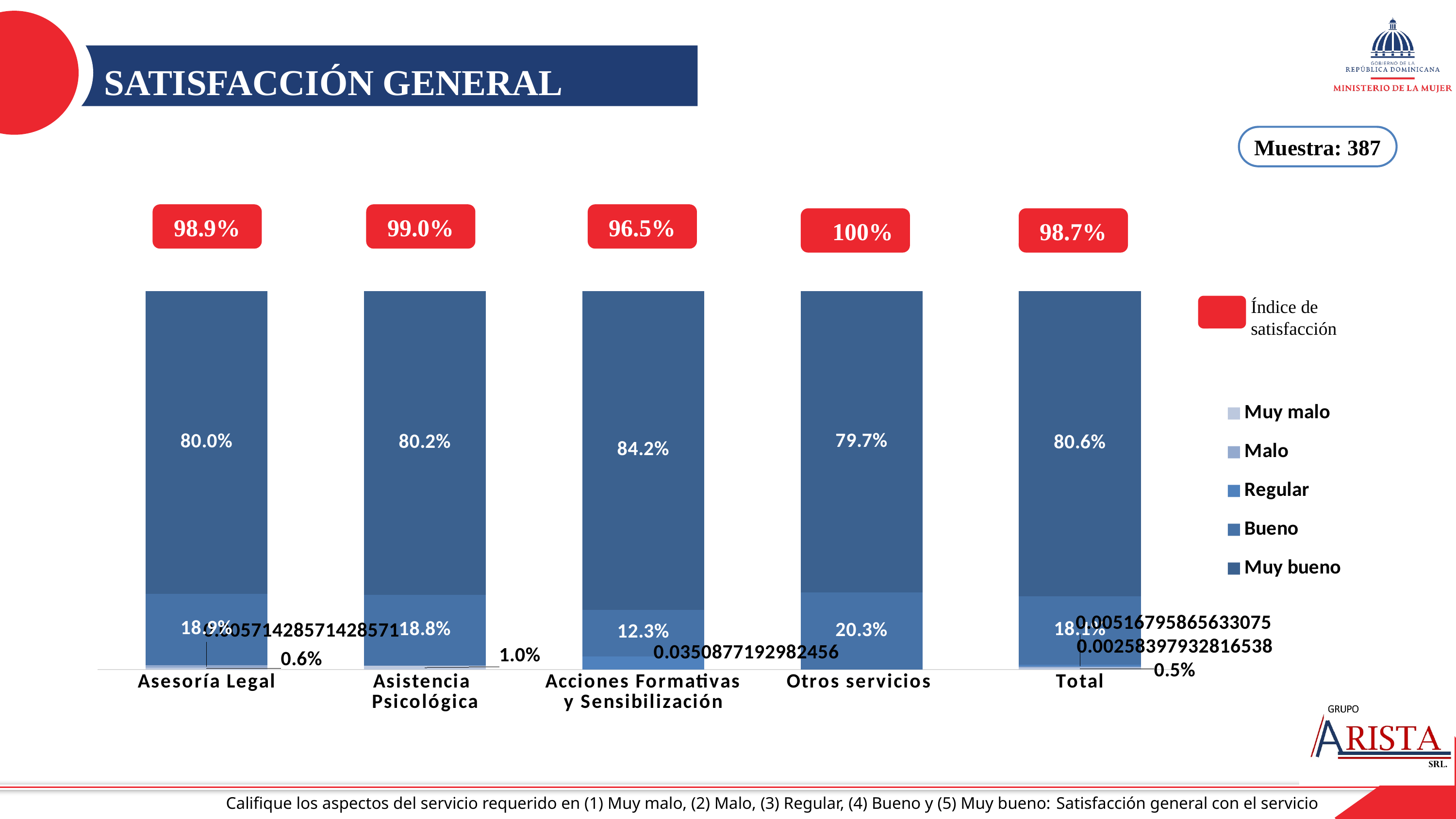
What sample size (Muestra) is shown on the slide? 387 How many categories are shown along the x axis of the chart? 5 Is the Bueno value for Asesoría Legal or for Asistencia Psicológica larger? Asesoría Legal How many series does the chart legend list? 5 Which category has the highest Índice de satisfacción? Otros servicios What is the Bueno value for Otros servicios? 20.3% Which category has the lowest Bueno value? Acciones Formativas y Sensibilización Which category has the highest Muy bueno value? Acciones Formativas y Sensibilización What type of chart is shown on the slide? stacked bar chart What is the difference between the Muy bueno values for Total and Otros servicios? 0.9% What is the Índice de satisfacción shown for Asistencia Psicológica? 99.0% What is the Muy bueno value for Acciones Formativas y Sensibilización? 84.2%